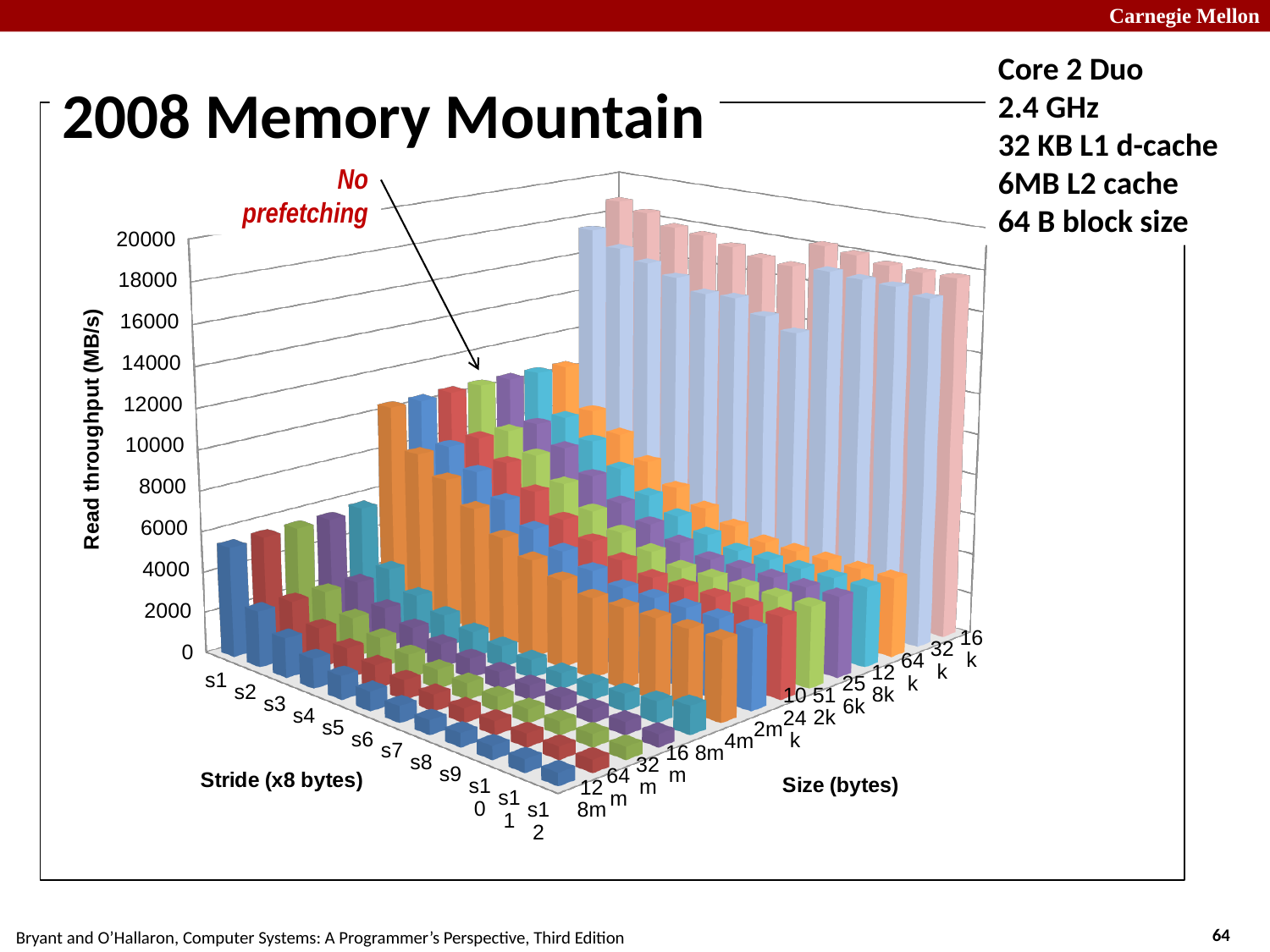
What is the title of the chart? 2008 Memory Mountain Is the read throughput for stride s1 at size 128m greater or less than 10000 MB/s? less Is the read throughput for stride s12 at size 16k greater or less than 14000 MB/s? greater What annotation with an arrow is placed on the chart? No prefetching Is the read throughput for stride s1 at size 16k greater or less than 16000 MB/s? greater Which size has higher read throughput at stride s1: 16k or 128m? 16k What kind of chart is shown on the slide? 3D bar chart How many stride categories are shown along the stride axis? 12